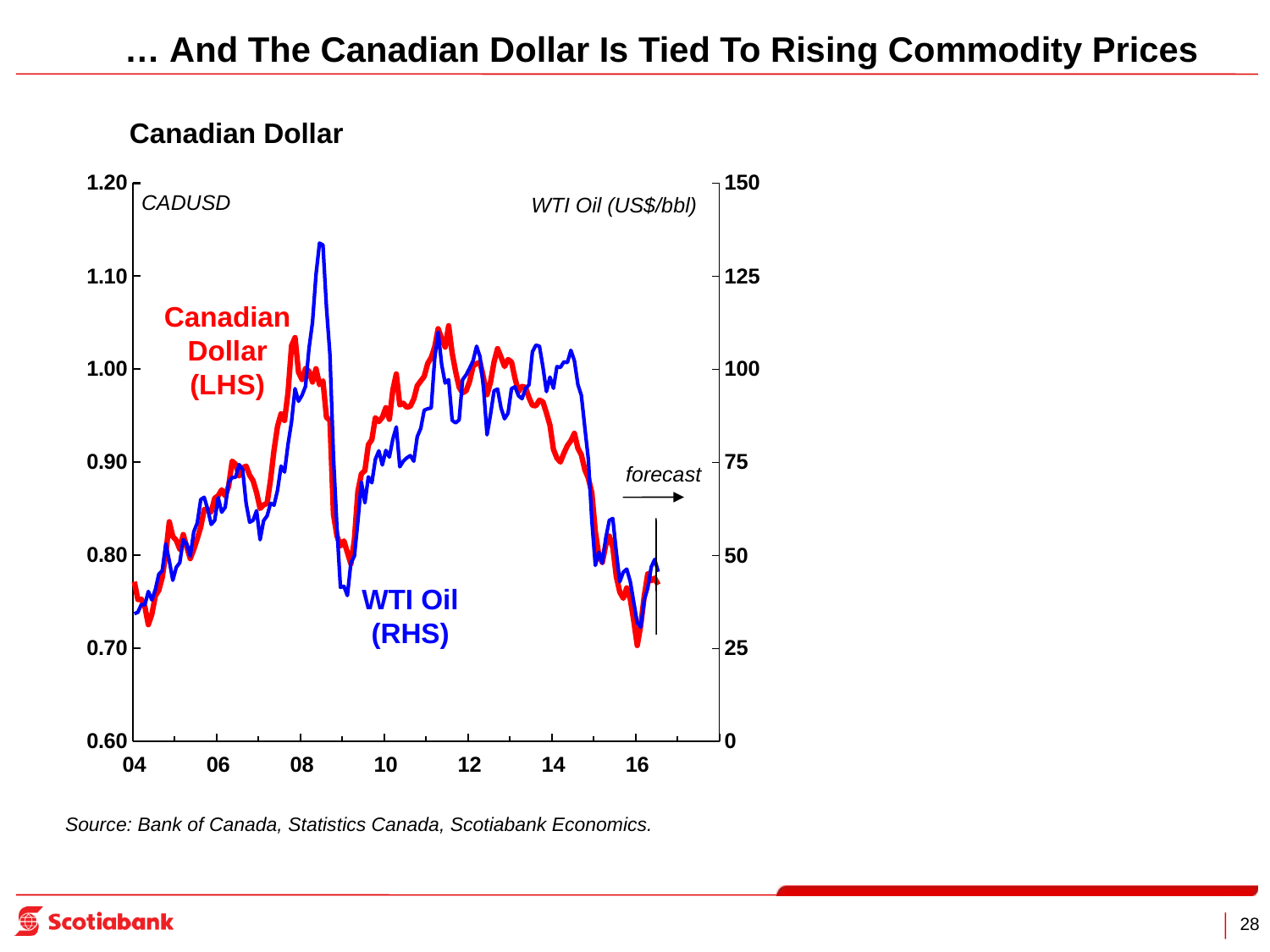
How many series are plotted on the chart? 2 Is the peak value of WTI Oil around 2008 greater or less than 125? greater What unit label is shown for the right-hand axis? WTI Oil (US$/bbl) Is the WTI Oil value at its 2009 trough greater or less than 50? less Is the Canadian Dollar's peak around 2011 greater or less than 1.00? greater Does WTI Oil rise or fall between 2009 and 2011? Rise What kind of chart is shown on the slide? Line chart What is the title of the chart? Canadian Dollar In which year does WTI Oil reach its highest value on the chart? 2008 Which series reaches its highest point in 2008, Canadian Dollar or WTI Oil? WTI Oil Does the Canadian Dollar rise or fall between 2011 and 2016? Fall